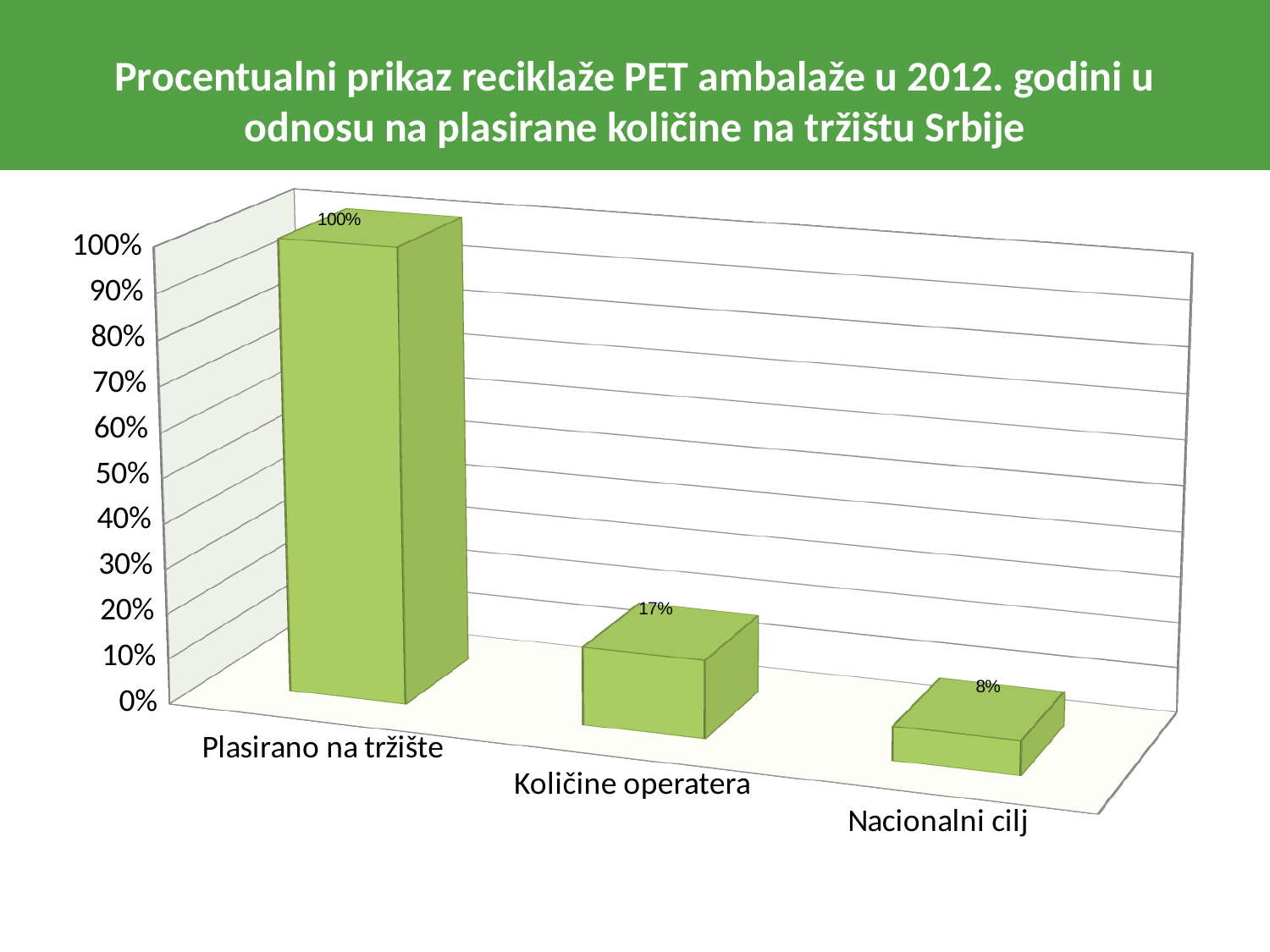
What kind of chart is shown on the slide? bar chart Which category has the lowest value? Nacionalni cilj What is the value for Nacionalni cilj? 8% Which category has the highest value? Plasirano na tržište How many categories are shown on the chart? 3 What is the value for Količine operatera? 17% What is the difference between the values for Količine operatera and Nacionalni cilj? 10% Is the value for Količine operatera greater or less than 20%? less What is the difference between the values for Plasirano na tržište and Količine operatera? 83% What is the value for Plasirano na tržište? 100% Which is larger, the value for Količine operatera or the value for Nacionalni cilj? Količine operatera Do the values rise or fall from left to right across the categories? fall